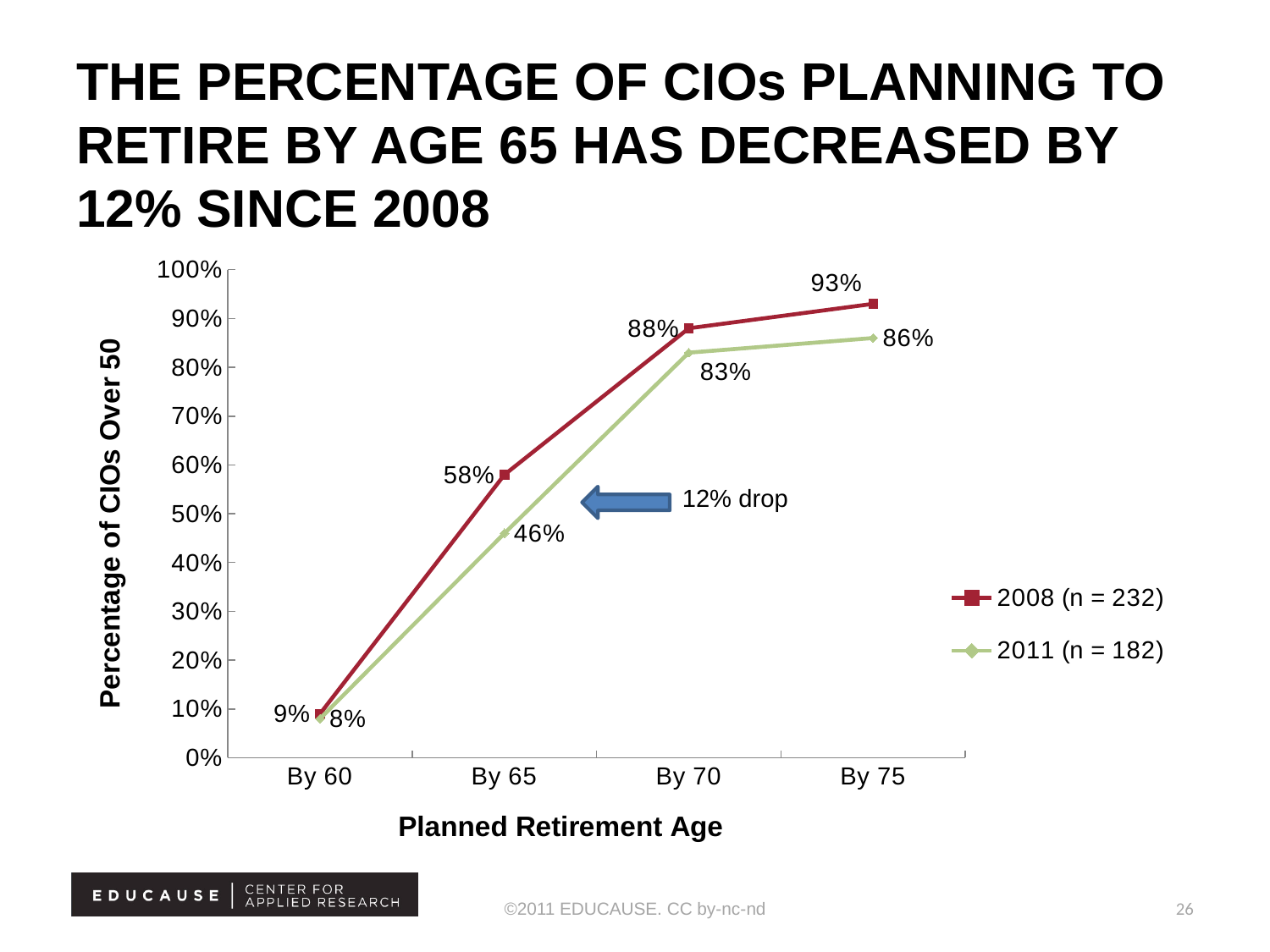
What percentage of CIOs over 50 planned to retire by 65 in 2011? 46% What kind of chart is shown on the slide? Line chart What is the difference between the 2008 and 2011 values for 'By 65'? 12% How many planned retirement age categories are shown on the x axis? 4 Which is larger for 'By 70': the 2008 value or the 2011 value? 2008 What percentage of CIOs over 50 planned to retire by 65 in 2008? 58% Which planned retirement age has the lowest value in the 2011 series? By 60 Which planned retirement age has the highest value in the 2008 series? By 75 Do the values in the 2011 series rise or fall as the planned retirement age increases? Rise How many series does the legend list? 2 What is the value for 'By 75' in the 2011 (n = 182) series? 86% What is the value for 'By 60' in the 2008 (n = 232) series? 9%